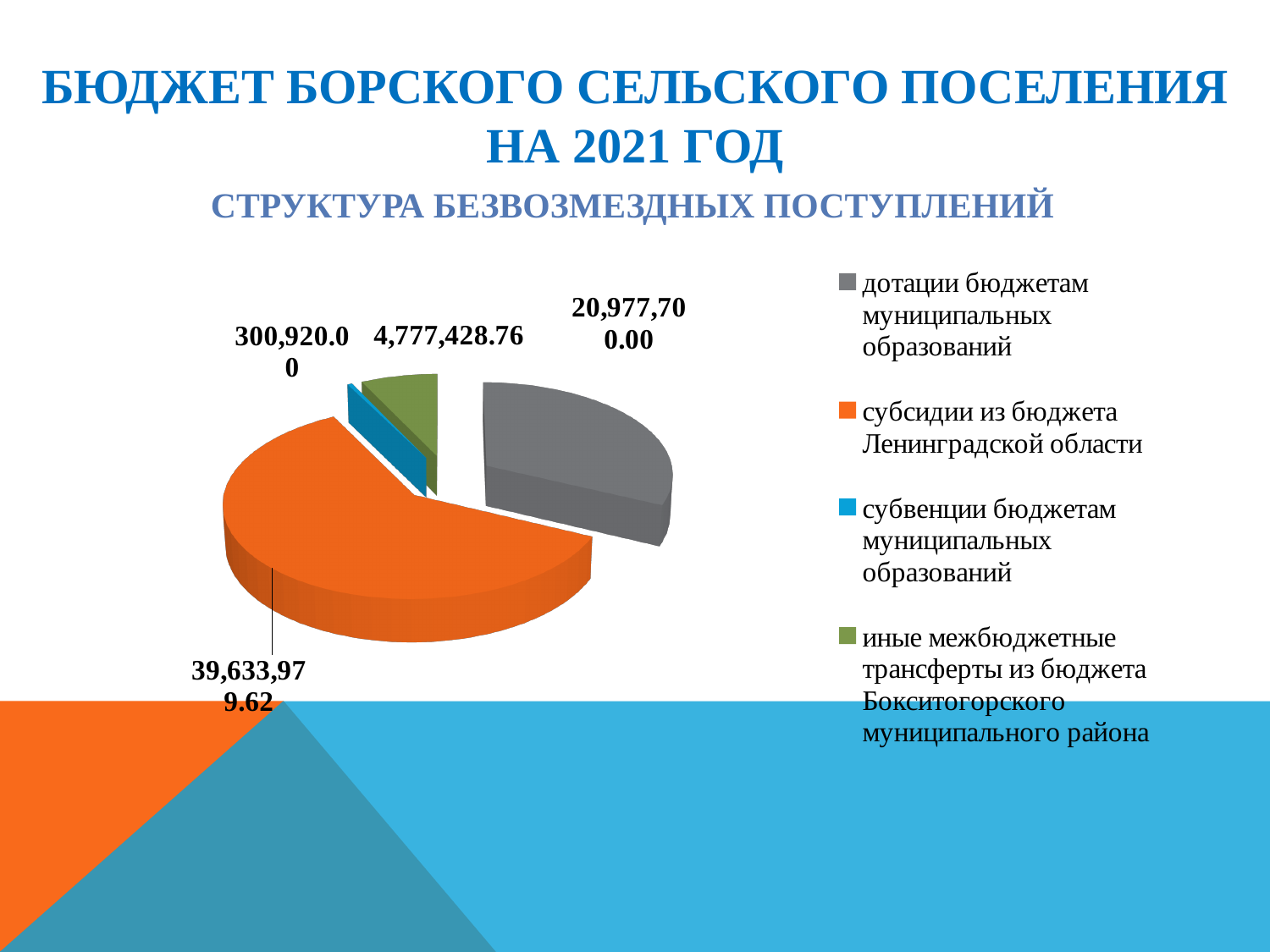
Which category has the smallest slice of the pie? субвенции бюджетам муниципальных образований What is the value for 'дотации бюджетам муниципальных образований'? 20,977,700.00 What is the value for 'иные межбюджетные трансферты из бюджета Бокситогорского муниципального района'? 4,777,428.76 How many entries does the legend list? 4 What is the value for 'субсидии из бюджета Ленинградской области'? 39,633,979.62 How many slices does the pie chart have? 4 What is the value for 'субвенции бюджетам муниципальных образований'? 300,920.00 Which category has the largest slice of the pie? субсидии из бюджета Ленинградской области Which is larger: 'дотации бюджетам муниципальных образований' or 'иные межбюджетные трансферты из бюджета Бокситогорского муниципального района'? дотации бюджетам муниципальных образований What is the difference between the value for 'субсидии из бюджета Ленинградской области' and the value for 'дотации бюджетам муниципальных образований'? 18,656,279.62 What type of chart is shown on the slide? Pie chart What colour is the slice for 'субсидии из бюджета Ленинградской области'? Orange